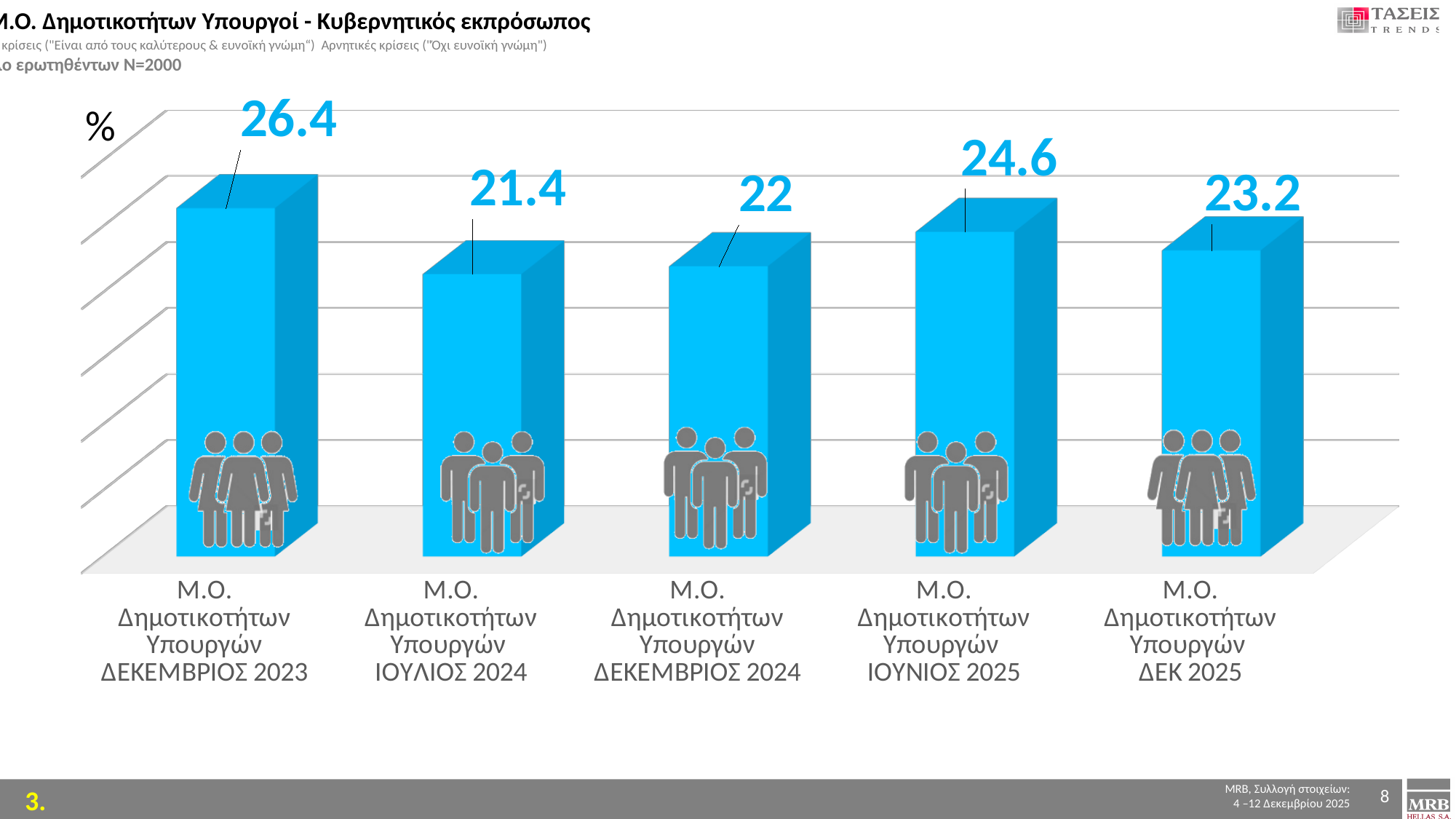
What is the value for Μ.Ο. Δημοτικότητων Υπουργών ΙΟΥΝΙΟΣ 2025? 24.6 What is the value for Μ.Ο. Δημοτικότητων Υπουργών ΔΕΚΕΜΒΡΙΟΣ 2023? 26.4 How many bars are shown in the chart? 5 What is the value for Μ.Ο. Δημοτικότητων Υπουργών ΔΕΚ 2025? 23.2 Which period has the lowest value? ΙΟΥΛΙΟΣ 2024 What is the difference between the values for ΔΕΚΕΜΒΡΙΟΣ 2023 and ΙΟΥΛΙΟΣ 2024? 5 What is the value for Μ.Ο. Δημοτικότητων Υπουργών ΙΟΥΛΙΟΣ 2024? 21.4 What is the value for Μ.Ο. Δημοτικότητων Υπουργών ΔΕΚΕΜΒΡΙΟΣ 2024? 22 What kind of chart is shown on the slide? Bar chart What unit symbol is shown at the top of the chart's axis? % Which period has the highest value? ΔΕΚΕΜΒΡΙΟΣ 2023 Which is larger, the value for ΙΟΥΝΙΟΣ 2025 or the value for ΔΕΚ 2025? ΙΟΥΝΙΟΣ 2025